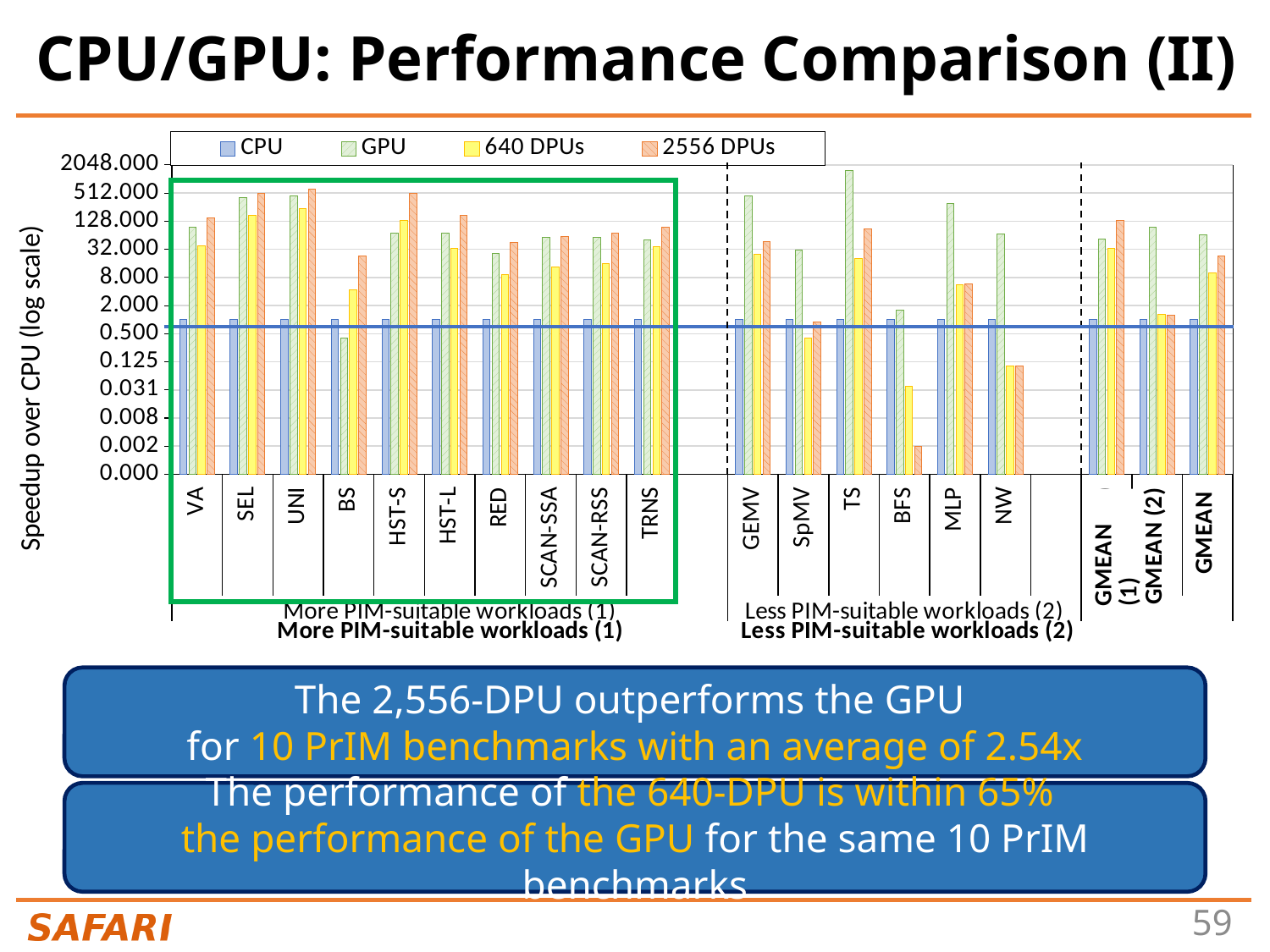
Which workload has the lowest 2556 DPUs bar? BFS What kind of chart is shown on the slide? bar chart Is the GPU value for TS greater or less than 512? greater For BS, which is larger: the GPU value or the 2556 DPUs value? 2556 DPUs What is the label of the y axis? Speedup over CPU (log scale) Is the GPU value for SEL greater or less than 128? greater Which workload has the highest GPU bar? TS For GEMV, which is larger: the GPU value or the 2556 DPUs value? GPU How many series does the legend list? 4 Is the 2556 DPUs value for BFS greater or less than 0.031? less Which series are listed in the legend? CPU, GPU, 640 DPUs, 2556 DPUs